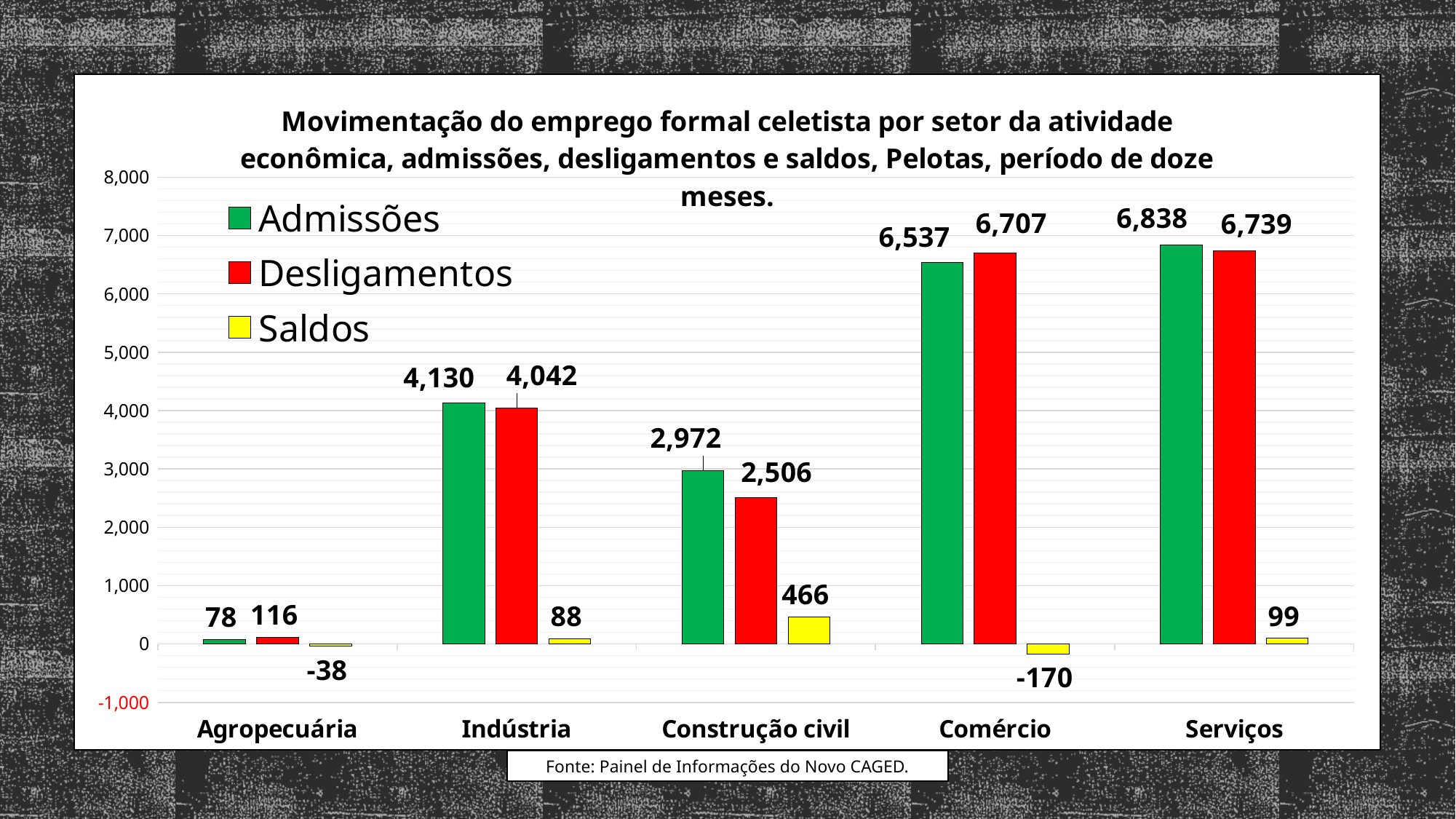
How many series does the legend list? 3 What is the Admissões value for Indústria? 4,130 What is the Saldos value for Comércio? -170 How many sectors are shown on the x axis? 5 Which sector has the highest Admissões value? Serviços What is the difference between Admissões and Desligamentos for Comércio? 170 Which colour represents Saldos in the legend? yellow What is the Desligamentos value for Construção civil? 2,506 What kind of chart is shown on the slide? bar chart Which is larger for Serviços, Admissões or Desligamentos? Admissões Is the Admissões value for Construção civil greater or less than 3,000? less Which sector has the lowest Desligamentos value? Agropecuária